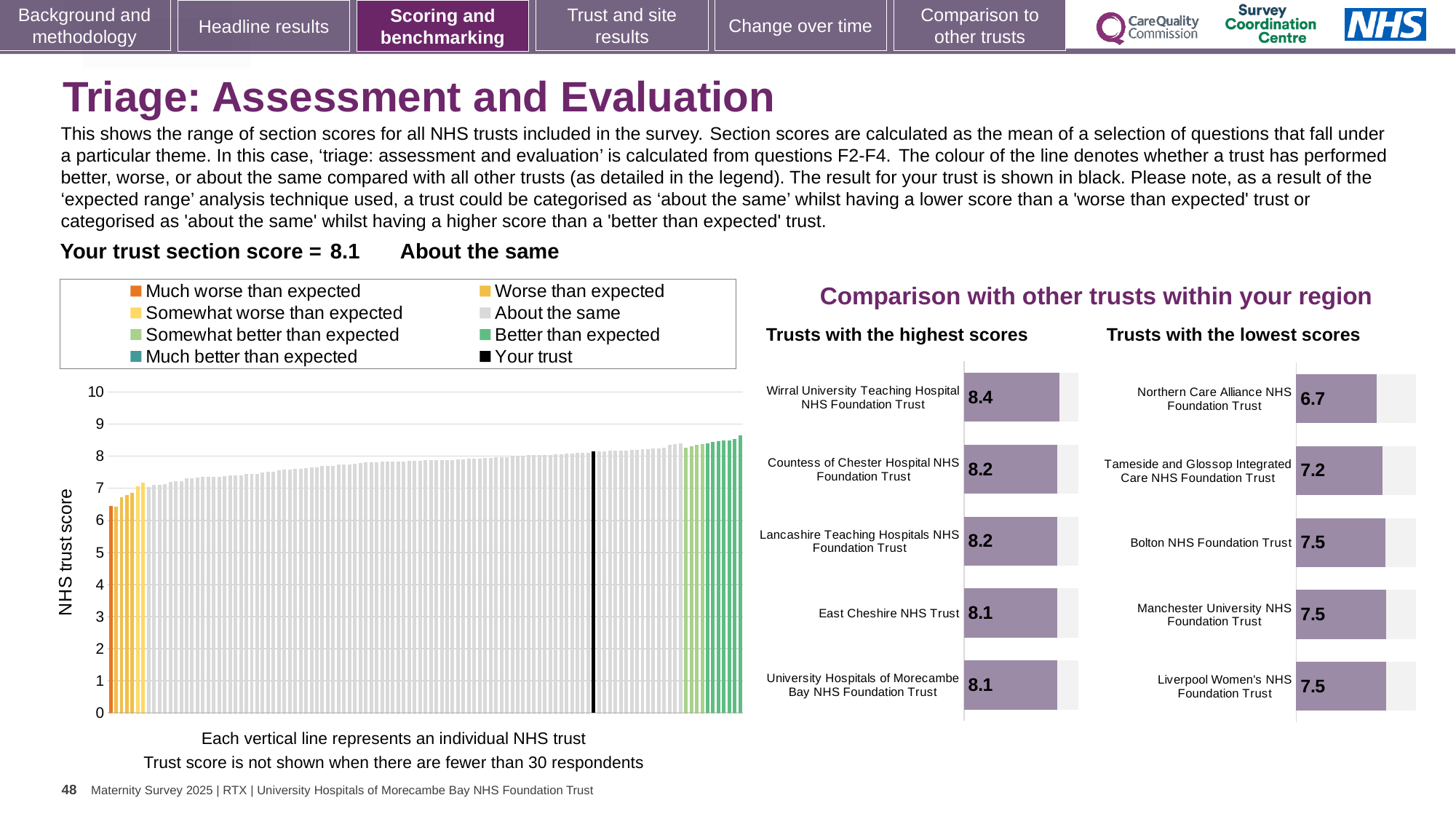
In the 'Trusts with the lowest scores' chart, which trust has the lowest score? Northern Care Alliance NHS Foundation Trust In the large NHS trust score chart on the left, is the value of the lowest bar greater or less than 7? less In the 'Trusts with the lowest scores' chart, what is the difference between the scores for Tameside and Glossop Integrated Care NHS Foundation Trust and Northern Care Alliance NHS Foundation Trust? 0.5 In the 'Trusts with the highest scores' chart, what is the score for Wirral University Teaching Hospital NHS Foundation Trust? 8.4 In the 'Trusts with the lowest scores' chart, what is the score for Northern Care Alliance NHS Foundation Trust? 6.7 In the 'Trusts with the highest scores' chart, which has the larger score: Wirral University Teaching Hospital NHS Foundation Trust or East Cheshire NHS Trust? Wirral University Teaching Hospital NHS Foundation Trust What is the difference between the score for Wirral University Teaching Hospital NHS Foundation Trust in the highest scores chart and the score for Northern Care Alliance NHS Foundation Trust in the lowest scores chart? 1.7 What kind of chart is the large NHS trust score chart on the left? bar chart How many entries does the legend of the large NHS trust score chart list? 8 In the 'Trusts with the highest scores' chart, which trust has the highest score? Wirral University Teaching Hospital NHS Foundation Trust How many trusts are shown in the 'Trusts with the lowest scores' chart? 5 In the 'Trusts with the lowest scores' chart, what is the score for Tameside and Glossop Integrated Care NHS Foundation Trust? 7.2